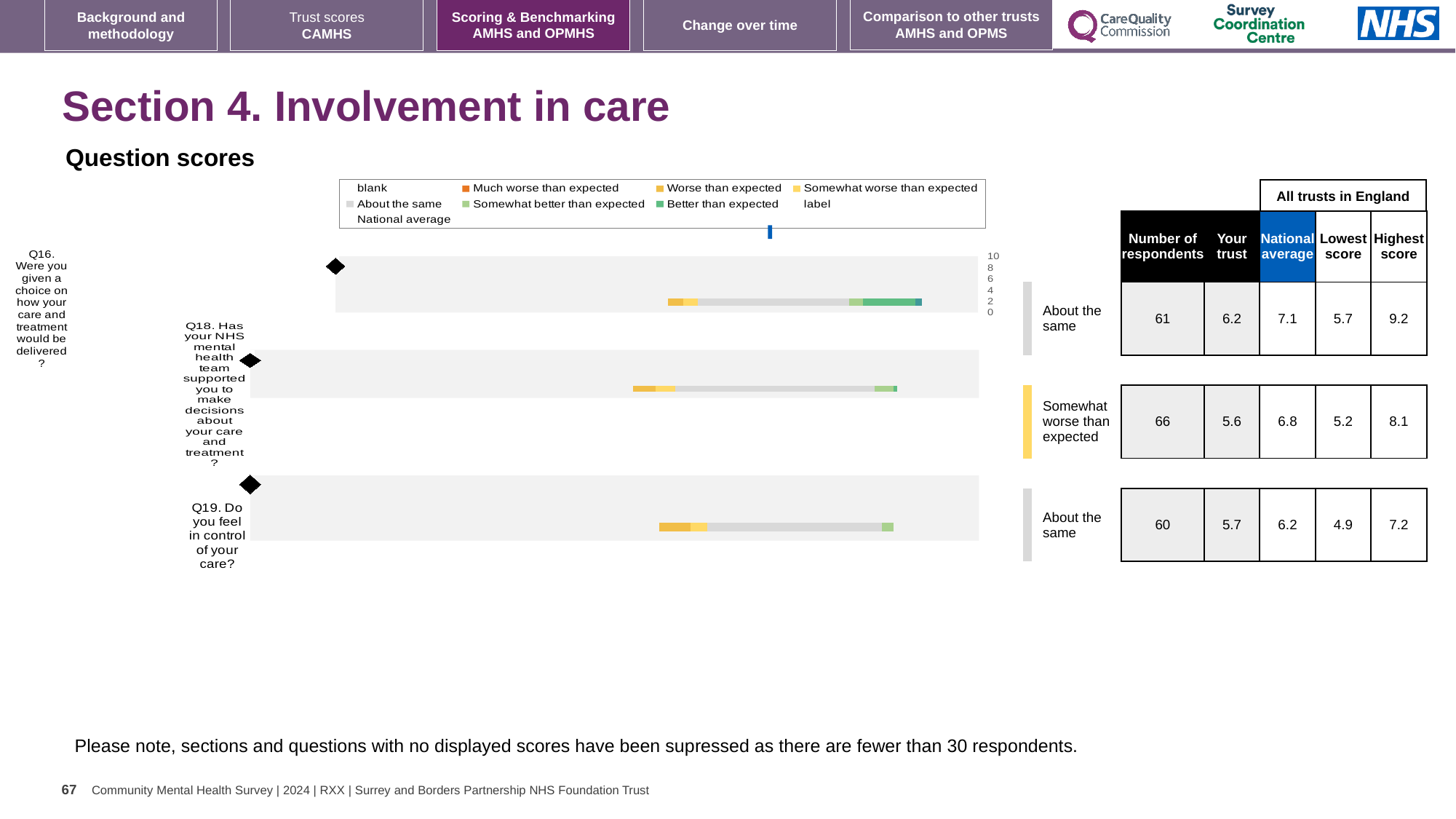
How many respondents answered Q19 (Do you feel in control of your care?)? 60 What is the 'Your trust' score for Q16 (Were you given a choice on how your care and treatment would be delivered?)? 6.2 Which has the larger 'Your trust' score, Q18 or Q19? Q19 What is the highest score among all trusts in England for Q18? 8.1 What is the difference between the highest score and the lowest score for Q19? 2.3 Which question has the lowest national average score? Q19 What benchmark category is shown for Q18? Somewhat worse than expected For Q16, how much higher is the national average than the 'Your trust' score? 0.9 How many questions are plotted in the question scores chart? 3 What kind of chart is used to show the question scores on this slide? bar chart Which question has the highest 'Your trust' score? Q16 What is the national average score for Q18 (Has your NHS mental health team supported you to make decisions about your care and treatment?)? 6.8